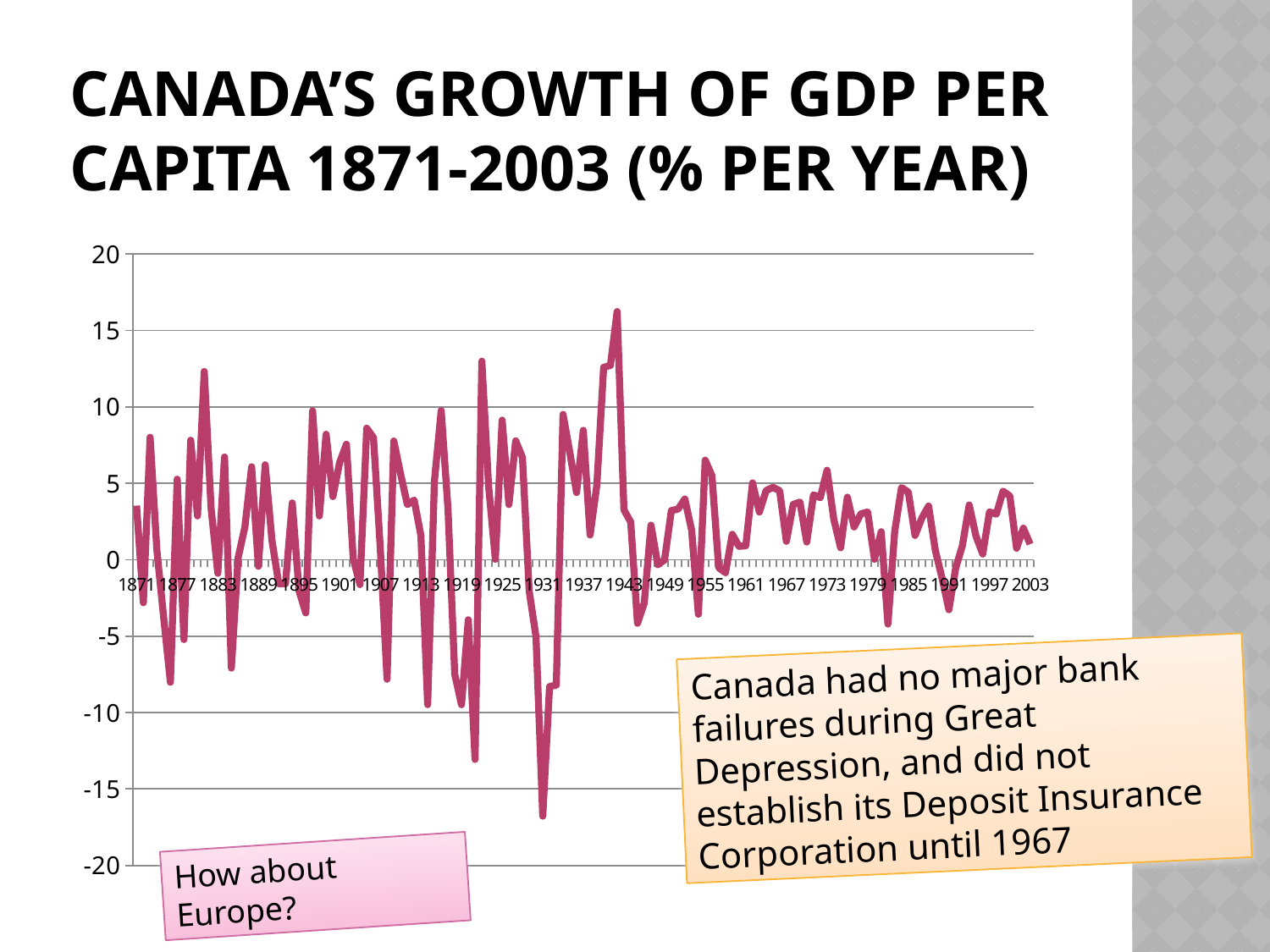
Is the lowest value plotted on the chart greater or less than -15? less What is the title of the chart on the slide? CANADA'S GROWTH OF GDP PER CAPITA 1871-2003 (% PER YEAR) Is the value for 2003 greater or less than 5? less What is the first year labelled on the x axis? 1871 What is the last year labelled on the x axis? 2003 Is the value for 1871 greater or less than 0? greater How many year labels are shown along the x axis? 23 What is the highest value shown on the vertical axis? 20 What kind of chart is shown on the slide? line chart